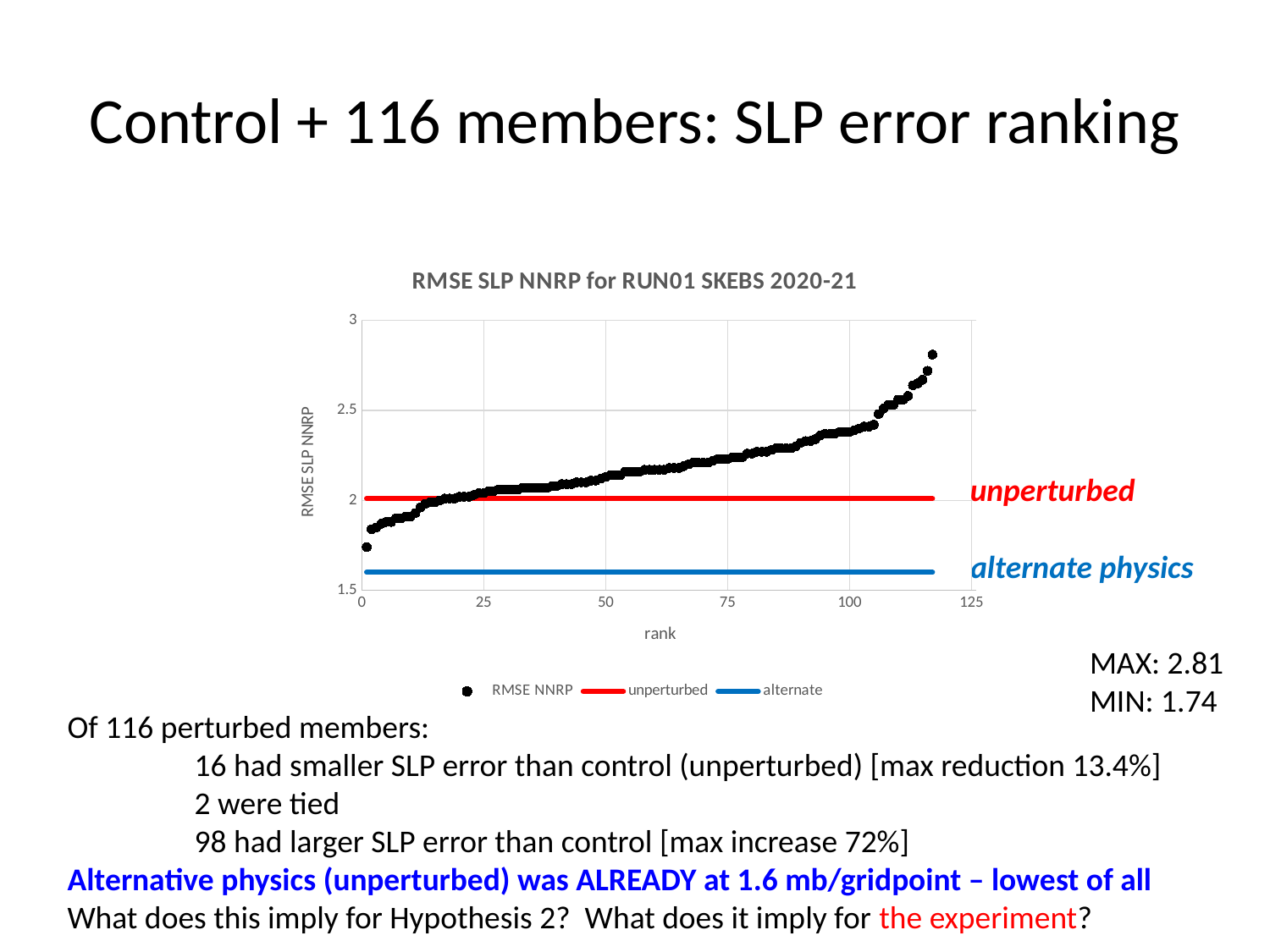
What is the maximum RMSE SLP NNRP value among the plotted members? 2.81 What RMSE value does the alternate physics line sit at, according to the slide? 1.6 Do the RMSE NNRP points rise or fall as rank increases? rise What is the title of the chart? RMSE SLP NNRP for RUN01 SKEBS 2020-21 Is the value of the alternate physics line greater or less than 2? less Which is larger, the unperturbed line or the alternate line? unperturbed How many series does the chart legend list? 3 What is the minimum RMSE SLP NNRP value among the plotted members? 1.74 What is the difference between the maximum (2.81) and minimum (1.74) RMSE values? 1.07 What kind of chart is shown on the slide? scatter chart Is the value of the unperturbed line greater or less than 2.5? less What is the label of the x axis of the chart? rank